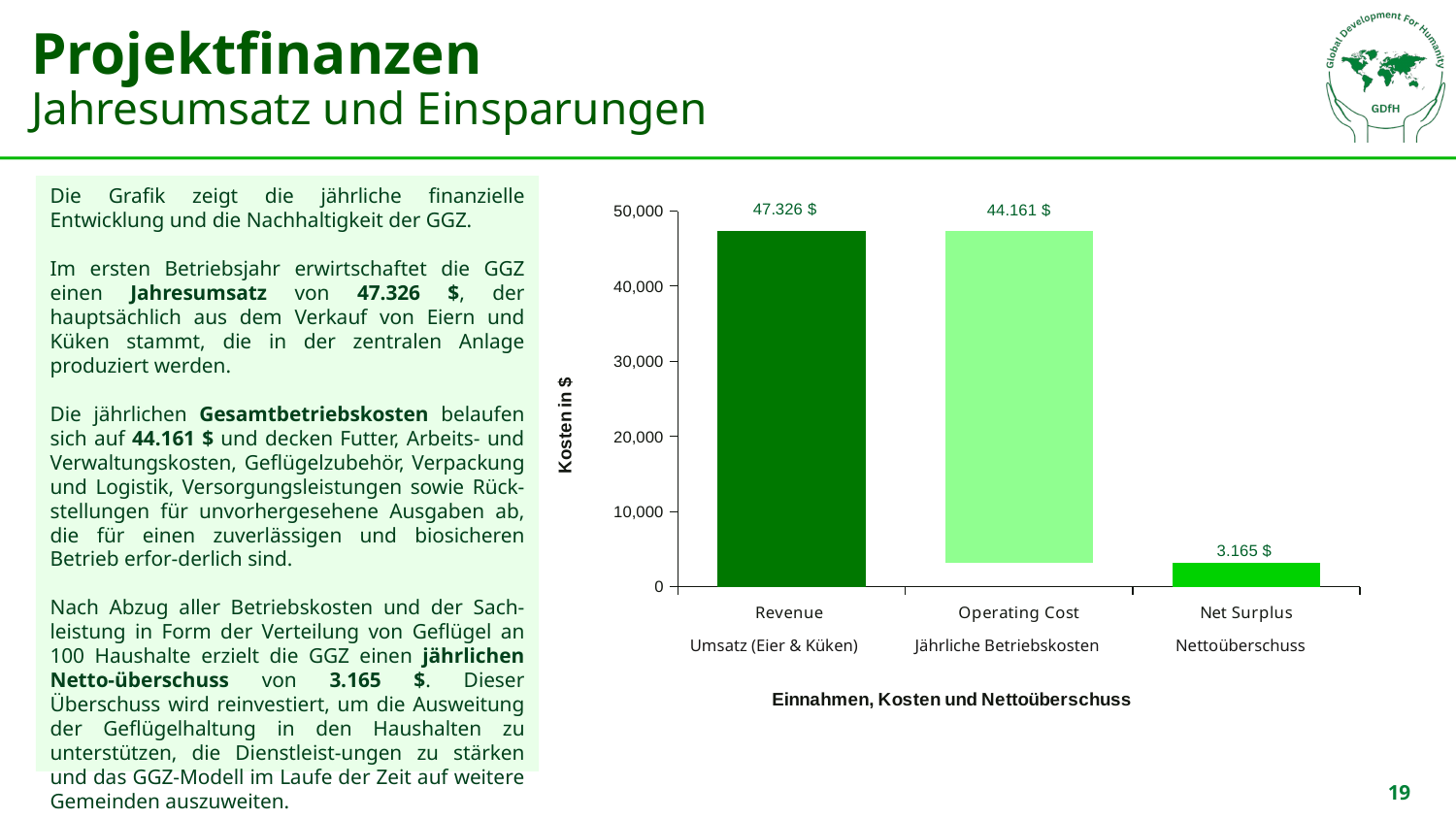
Which is larger, Revenue or Operating Cost? Revenue What is the difference between Operating Cost and Net Surplus? 40.996 $ Is the value for Net Surplus greater or less than 10,000? less What is the title of the chart? Einnahmen, Kosten und Nettoüberschuss Which category has the highest value? Revenue What is the value shown for Revenue? 47.326 $ What is the value shown for Net Surplus? 3.165 $ Which category has the lowest value? Net Surplus What is the difference between Revenue and Operating Cost? 3.165 $ What kind of chart is shown on the slide? bar chart What is the value shown for Operating Cost? 44.161 $ How many categories are shown in the chart? 3